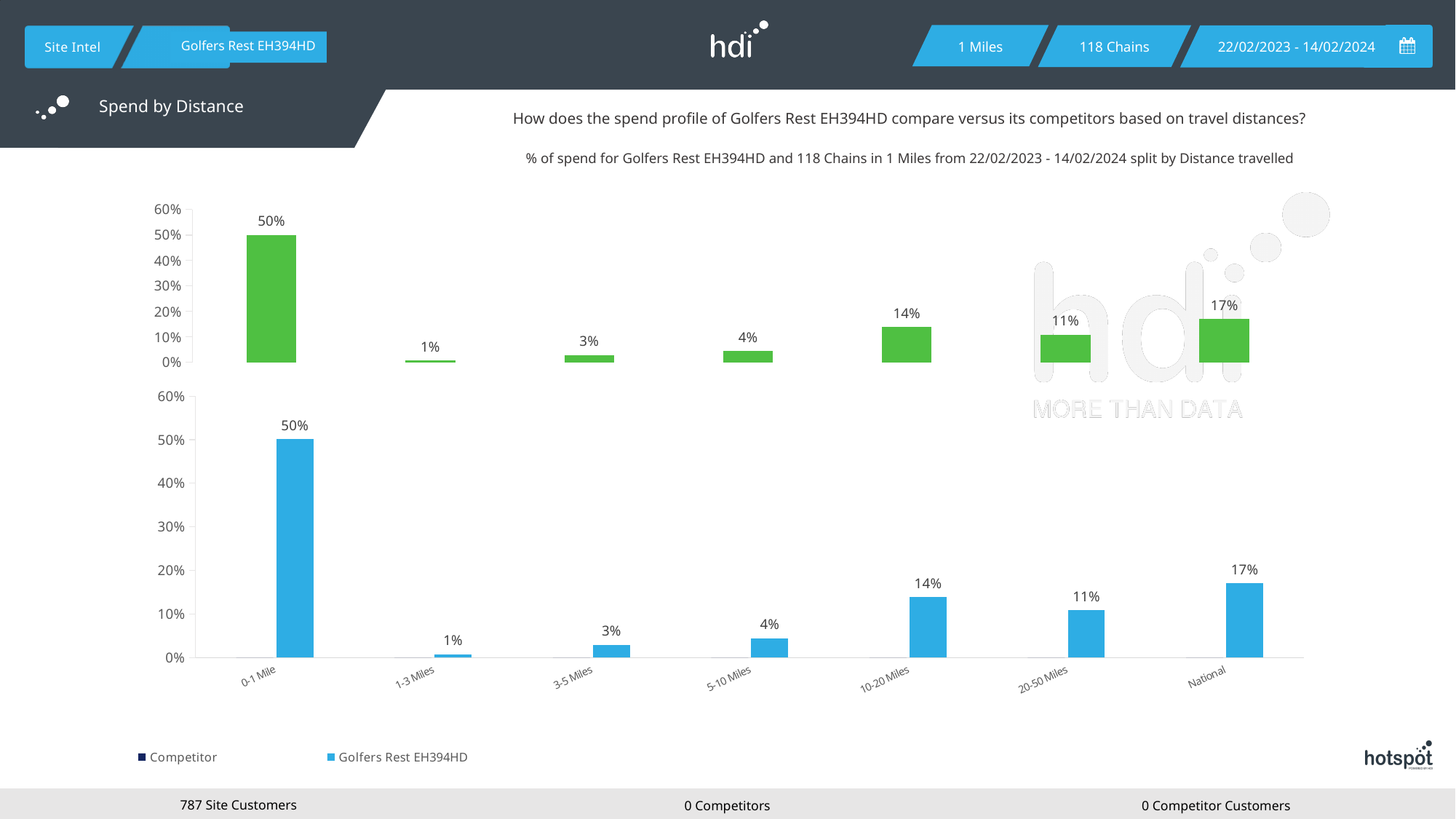
How many series does the legend at the bottom of the slide list? 2 In the lower blue bar chart, what is the value for 10-20 Miles? 14% In the lower blue bar chart, what is the difference between the values for 0-1 Mile and National? 33% In the lower blue bar chart, which distance band has the lowest share of spend? 1-3 Miles How many distance bands are shown on the x axis of the lower blue bar chart? 7 In the lower blue bar chart, which distance band has the highest share of spend? 0-1 Mile In the lower blue bar chart, what is the value for National? 17% In the lower blue bar chart, is the value for 5-10 Miles greater or less than 10%? less What type of chart is the lower chart on the slide? Bar chart In the lower blue bar chart, what is the value for 20-50 Miles? 11% In the lower blue bar chart, what is the value for 0-1 Mile? 50% In the lower blue bar chart, which is larger: the value for 10-20 Miles or the value for 20-50 Miles? 10-20 Miles